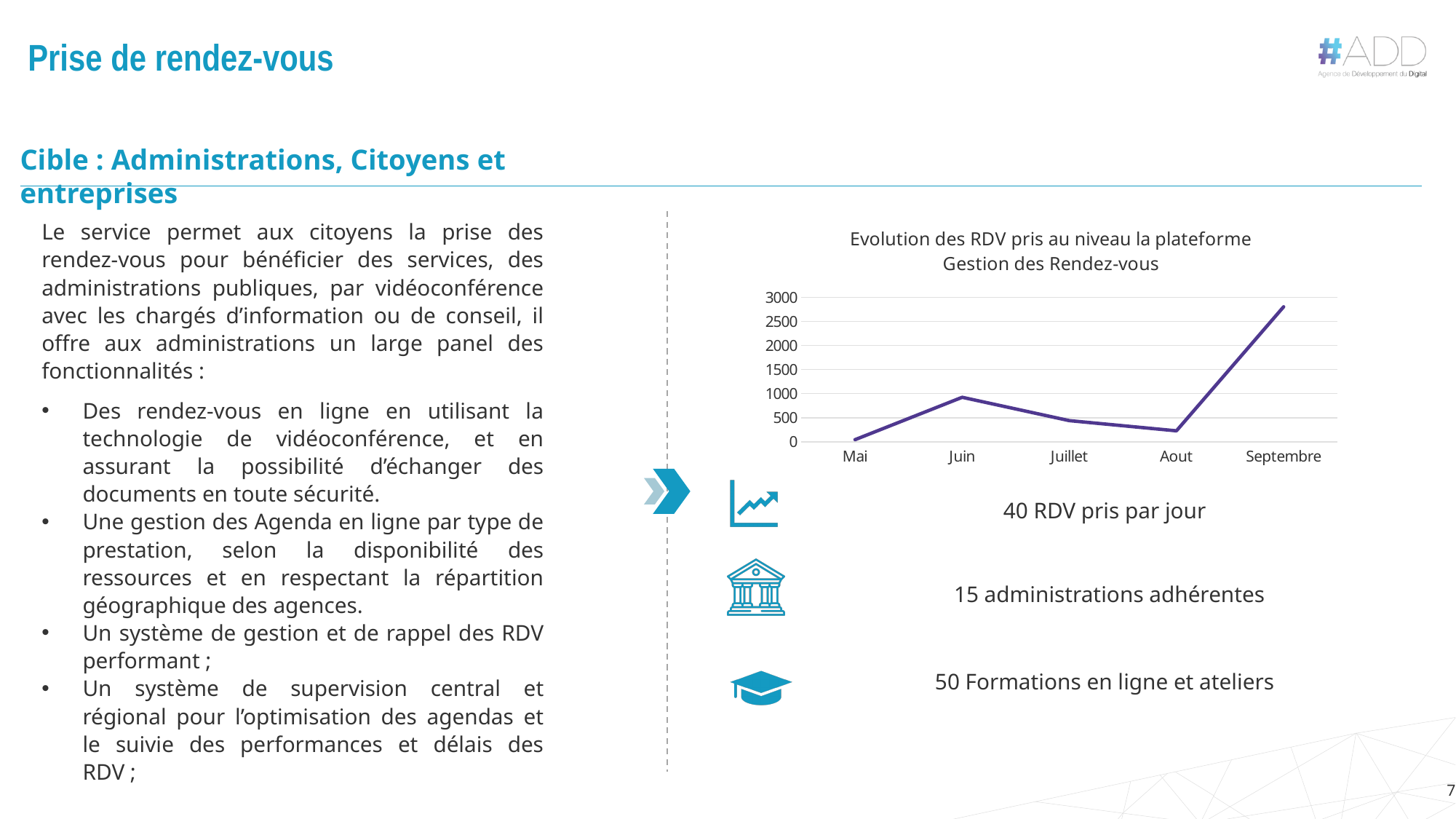
Which month has the lowest value in the chart? Mai How many months are plotted on the x axis of the chart? 5 What kind of chart is shown on the slide? line chart Is the value for Juin greater or less than 1000? less Which is larger, the value for Septembre or the value for Juin? Septembre Which is larger, the value for Juin or the value for Juillet? Juin Do the values rise or fall from Aout to Septembre? rise What is the title of the chart? Evolution des RDV pris au niveau la plateforme Gestion des Rendez-vous Is the value for Septembre greater or less than 2500? greater Is the value for Aout greater or less than 500? less Do the values rise or fall from Juin to Aout? fall Which month has the highest value in the chart? Septembre